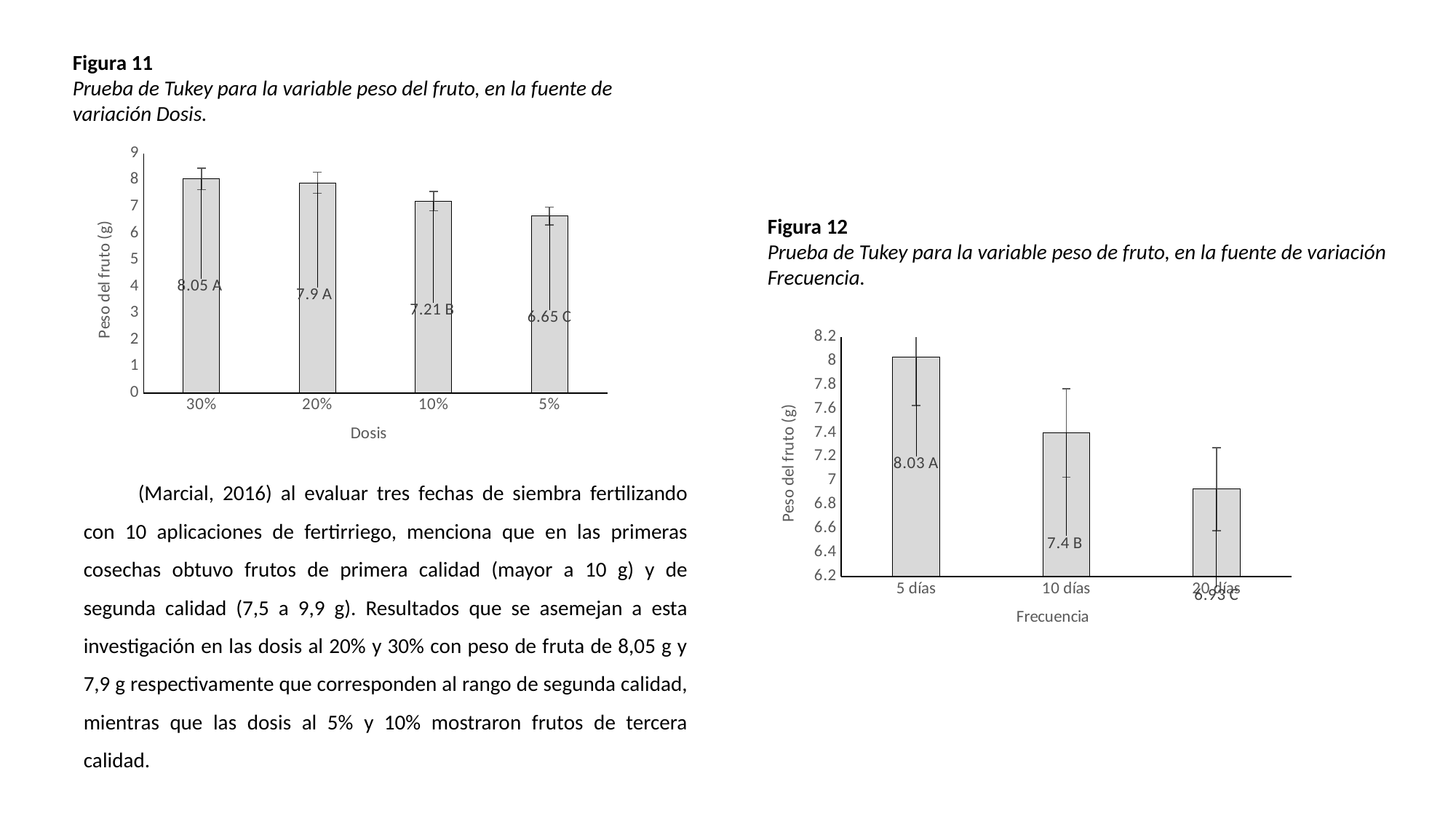
What kind of chart is the Figura 12 chart (Frecuencia)? bar chart In the Figura 11 chart (Dosis), which dose has the highest fruit weight? 30% In the Figura 12 chart (Frecuencia), is the fruit weight for 5 días greater or less than 7.8? greater In the Figura 11 chart (Dosis), what is the data label for the 10% dose bar? 7.21 B In the Figura 11 chart (Dosis), what is the data label for the 30% dose bar? 8.05 A In the Figura 11 chart (Dosis), do the fruit weight values rise or fall from left to right along the x axis? fall In the Figura 12 chart (Frecuencia), which frequency has the lowest fruit weight? 20 días In the Figura 12 chart (Frecuencia), what is the data label for the 10 días bar? 7.4 B In the Figura 11 chart (Dosis), what is the difference in fruit weight between the 30% dose and the 5% dose? 1.4 In the Figura 11 chart (Dosis), how many dose categories are shown on the x axis? 4 In the Figura 11 chart (Dosis), which dose has the lowest fruit weight? 5% In the Figura 12 chart (Frecuencia), what is the data label for the 5 días bar? 8.03 A